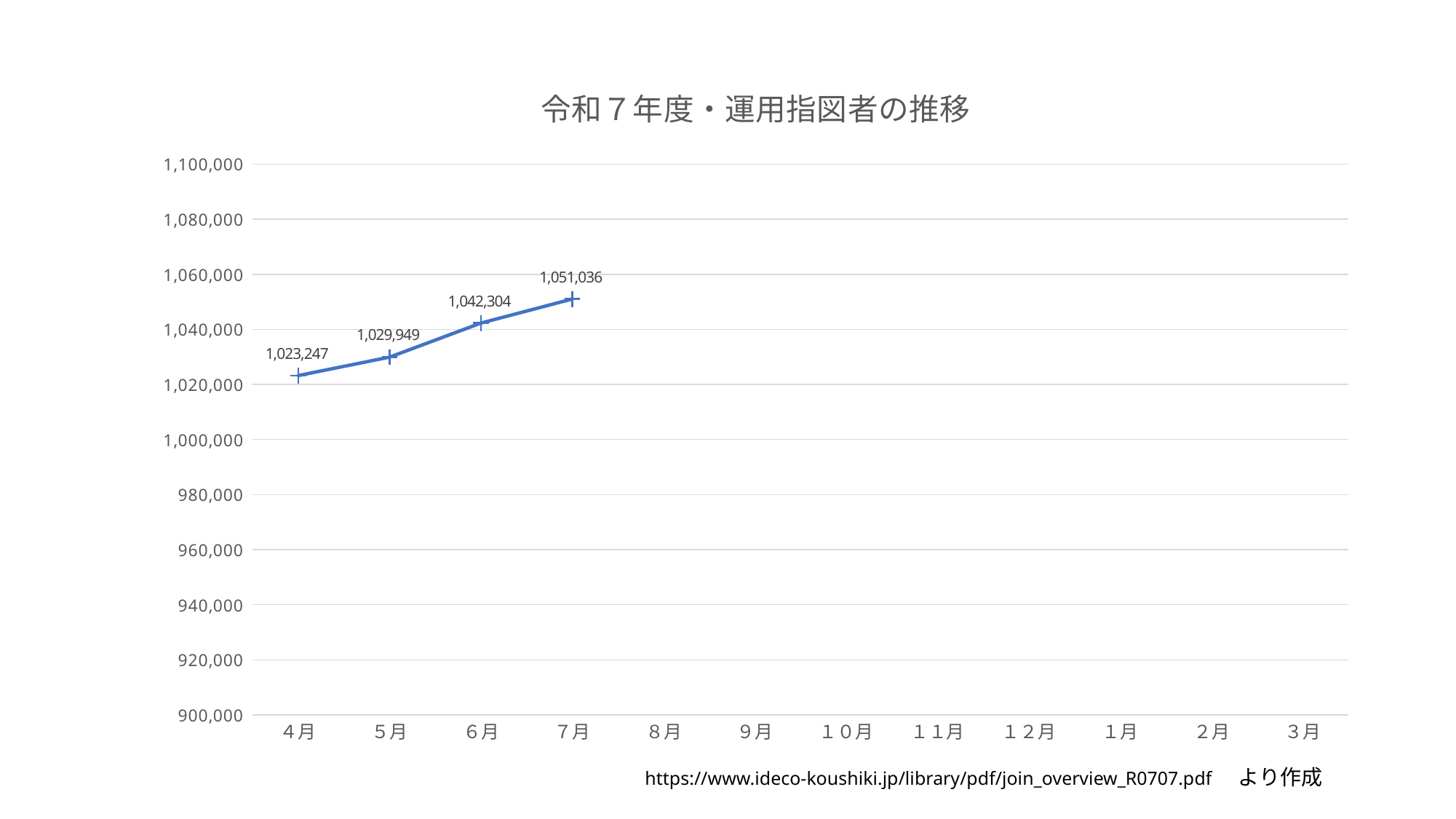
What is the value for 6月? 1,042,304 How many data points are plotted on the line? 4 What is the value for 7月? 1,051,036 What is the value for 5月? 1,029,949 Which month has the highest plotted value? 7月 Which is larger, the value for 5月 or the value for 6月? 6月 What is the value for 4月? 1,023,247 Is the value for 7月 greater or less than 1,040,000? greater What is the difference between the values for 7月 and 4月? 27,789 What is the difference between the values for 6月 and 5月? 12,355 What kind of chart is shown on the slide? line chart Which month has the lowest plotted value? 4月